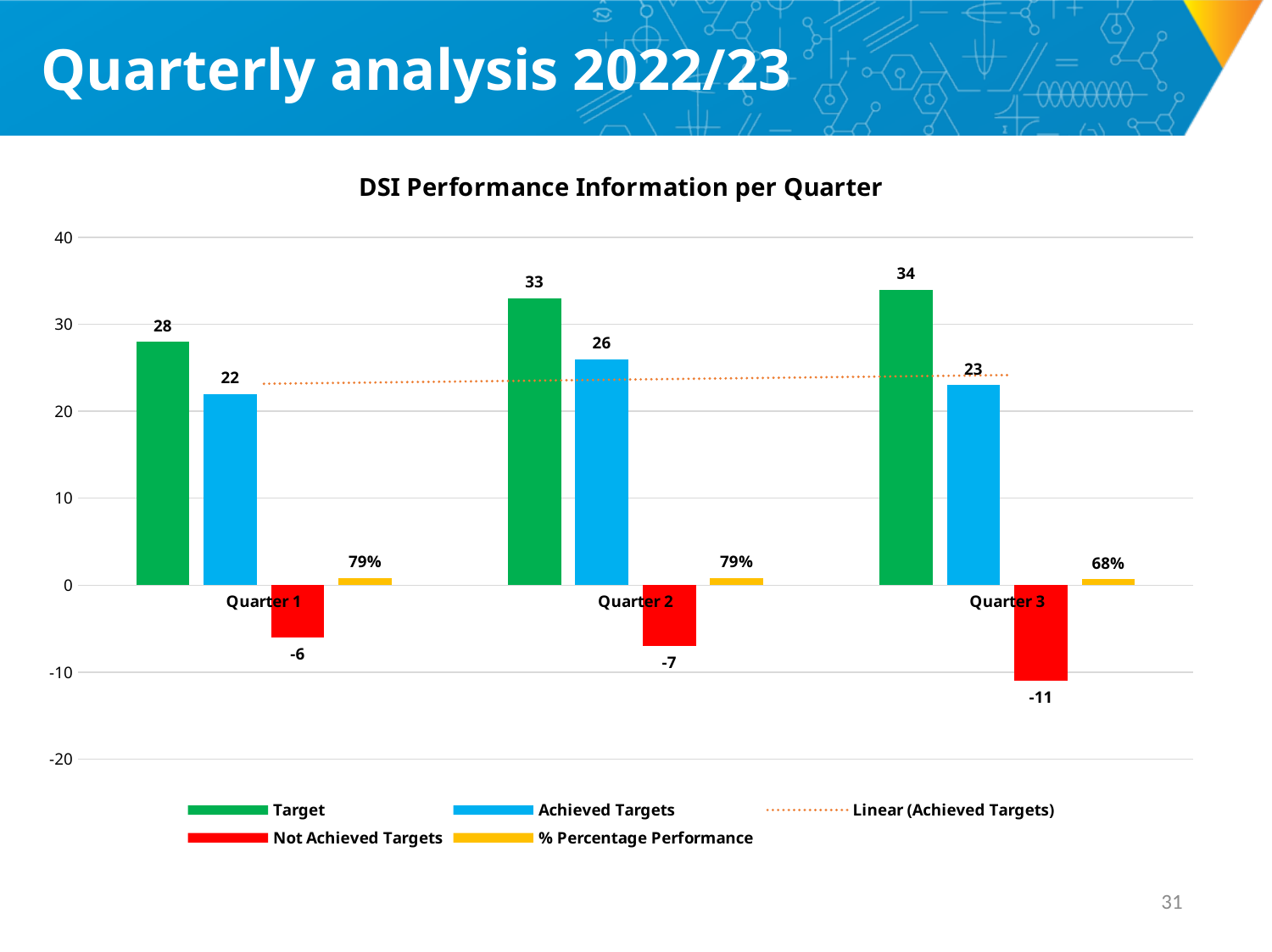
What is the Target value for Quarter 2? 33 What is the title of the chart? DSI Performance Information per Quarter What is the % Percentage Performance for Quarter 3? 68% What is the Achieved Targets value for Quarter 3? 23 How many entries does the legend list? 5 How many quarters are shown on the x axis? 3 What kind of chart is shown on the slide? Bar chart Is the Achieved Targets value larger in Quarter 2 or Quarter 3? Quarter 2 Which quarter has the lowest Achieved Targets value? Quarter 1 What is the difference between the Target and Achieved Targets values in Quarter 2? 7 Which quarter has the highest Target value? Quarter 3 What is the Not Achieved Targets value for Quarter 1? -6